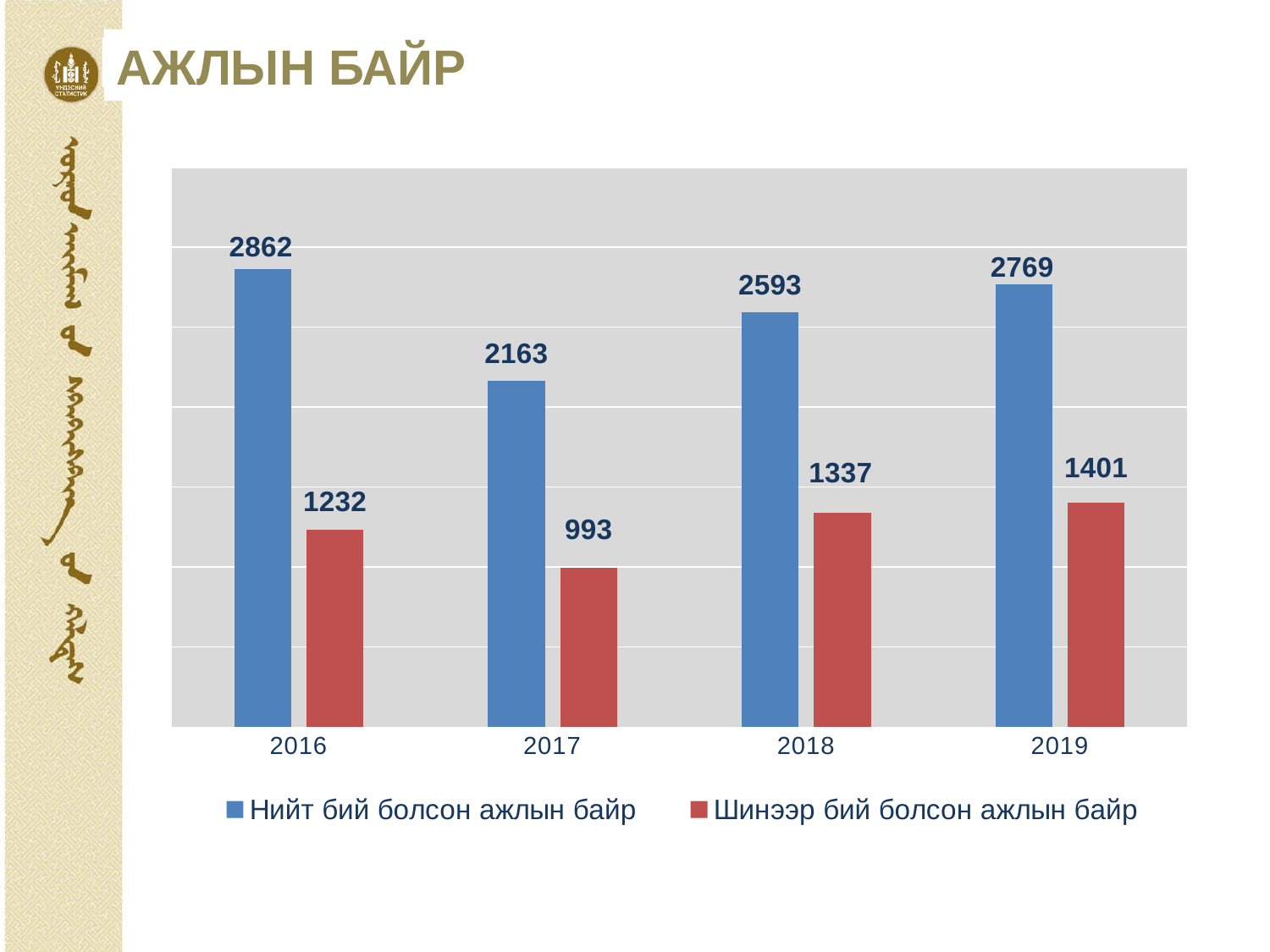
How many series does the legend list? 2 What is the value for "Нийт бий болсон ажлын байр" in 2019? 2769 What colour are the bars for "Нийт бий болсон ажлын байр"? blue Which year has the highest value for "Нийт бий болсон ажлын байр"? 2016 Which is larger: "Шинээр бий болсон ажлын байр" in 2016 or in 2019? 2019 Which year has the lowest value for "Шинээр бий болсон ажлын байр"? 2017 Does the value for "Шинээр бий болсон ажлын байр" rise or fall from 2017 to 2019? rise What is the value for "Нийт бий болсон ажлын байр" in 2016? 2862 What is the difference between "Нийт бий болсон ажлын байр" and "Шинээр бий болсон ажлын байр" in 2018? 1256 How many years are shown on the x axis? 4 What kind of chart is shown on the slide? bar chart What is the value for "Шинээр бий болсон ажлын байр" in 2017? 993